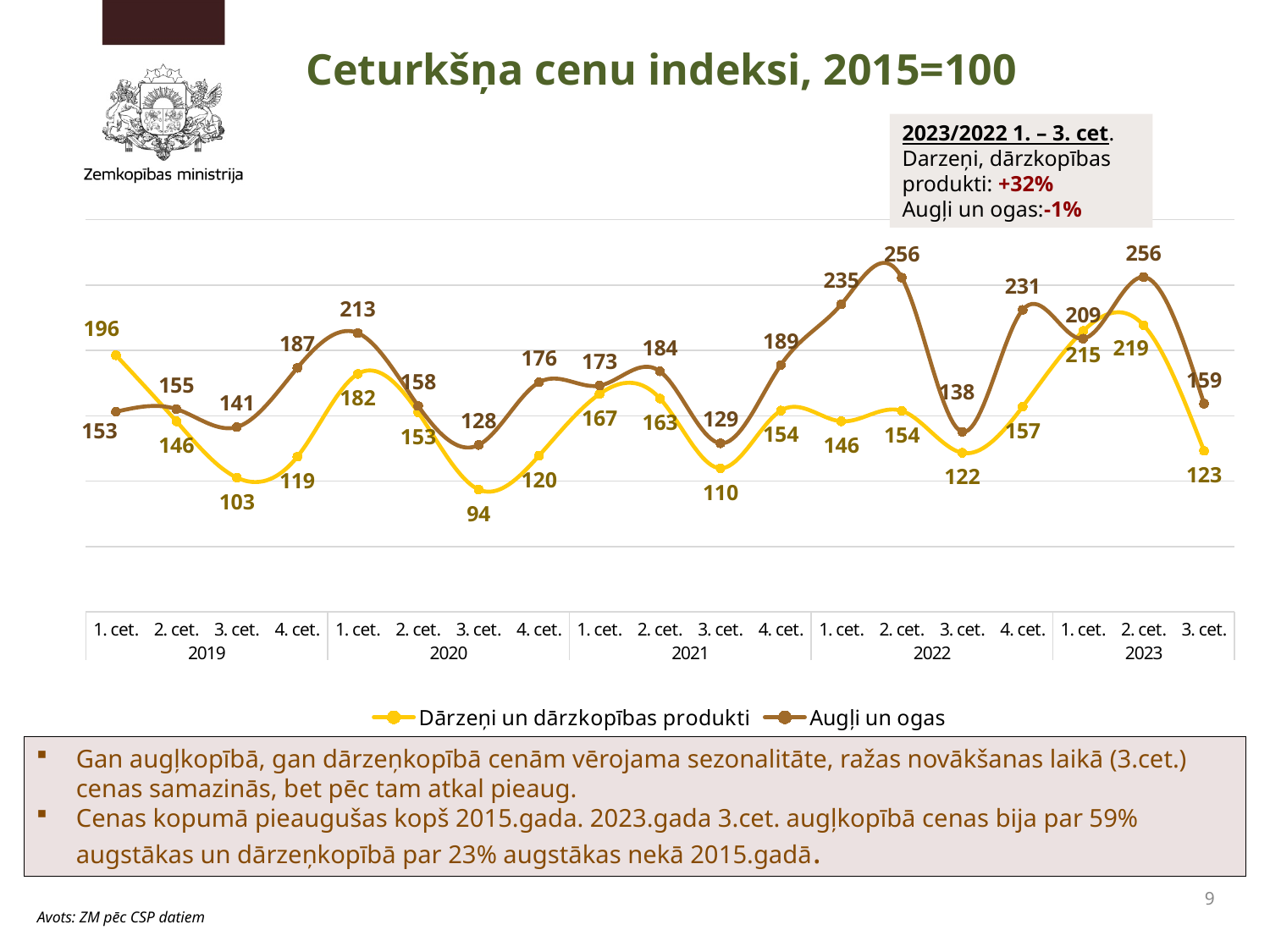
In which quarter does 'Augļi un ogas' reach its lowest value? 3. cet. 2020 How many quarters are plotted on the x axis? 19 What type of chart is shown on the slide? line chart What is the value of 'Dārzeņi un dārzkopības produkti' in 3. cet. 2020? 94 What is the value of 'Augļi un ogas' in 1. cet. 2022? 235 In which quarter does 'Dārzeņi un dārzkopības produkti' reach its highest value? 2. cet. 2023 What is the title of the chart? Ceturkšņa cenu indeksi, 2015=100 What is the difference between 'Augļi un ogas' and 'Dārzeņi un dārzkopības produkti' in 2. cet. 2022? 102 Which series has the higher value in 1. cet. 2019? Dārzeņi un dārzkopības produkti In which quarter does 'Dārzeņi un dārzkopības produkti' reach its lowest value? 3. cet. 2020 How many series does the legend list? 2 What is the value of 'Dārzeņi un dārzkopības produkti' in 2. cet. 2023? 219